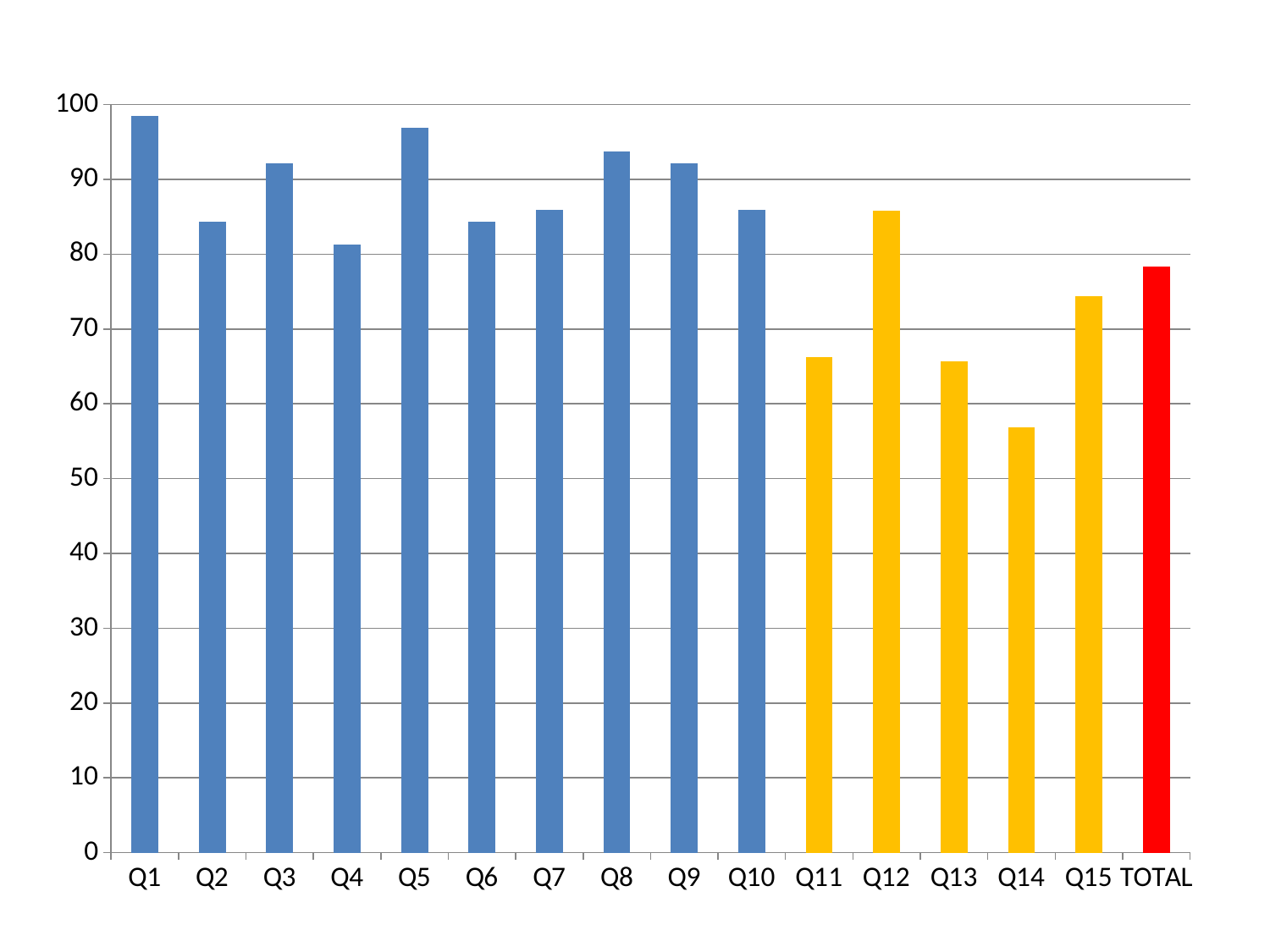
What colour is the TOTAL bar? red Is the value for Q13 greater or less than 70? less Is the value for Q14 greater or less than 60? less Which category has the lowest bar? Q14 Is the value for Q1 greater or less than 90? greater Which is larger, the value for Q14 or the value for Q15? Q15 Which is larger, the value for Q12 or the value for Q11? Q12 How many categories are plotted along the x axis? 16 What kind of chart is shown on the slide? bar chart